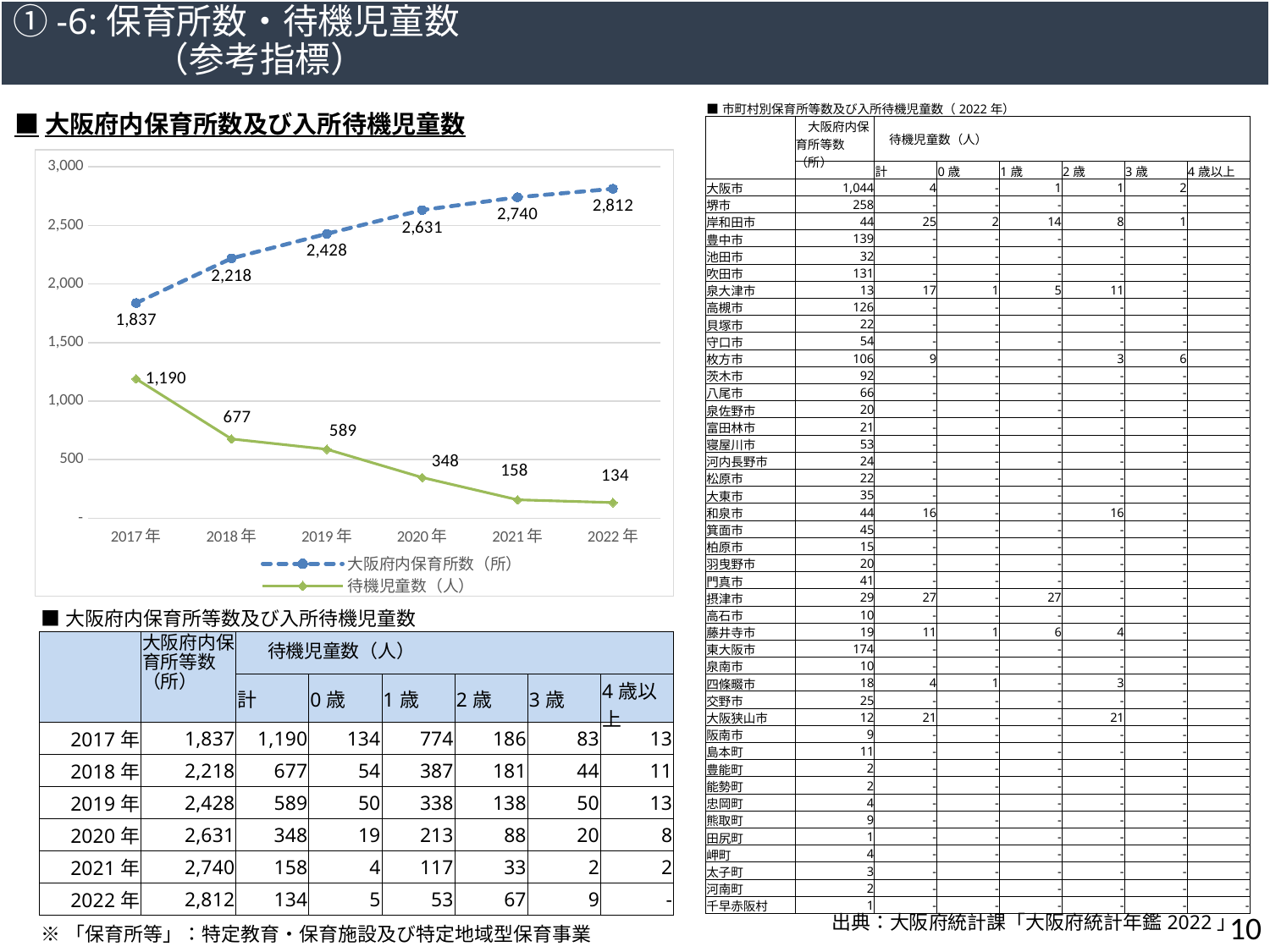
What is the difference between 大阪府内保育所数（所） in 2022年 and 2017年? 975 In which year is 待機児童数（人） highest? 2017年 In which year is 大阪府内保育所数（所） lowest? 2017年 What is the value of 大阪府内保育所数（所） for 2017年? 1,837 How many series does the chart legend list? 2 Does 待機児童数（人） rise or fall from 2017年 to 2022年? fall What is the value of 待機児童数（人） for 2020年? 348 What type of chart is shown on the slide? line chart How many years are plotted along the x axis of the chart? 6 Which series is drawn with a dashed line in the chart? 大阪府内保育所数（所） What is the value of 大阪府内保育所数（所） for 2022年? 2,812 Which is larger: 待機児童数（人） in 2018年 or in 2019年? 2018年